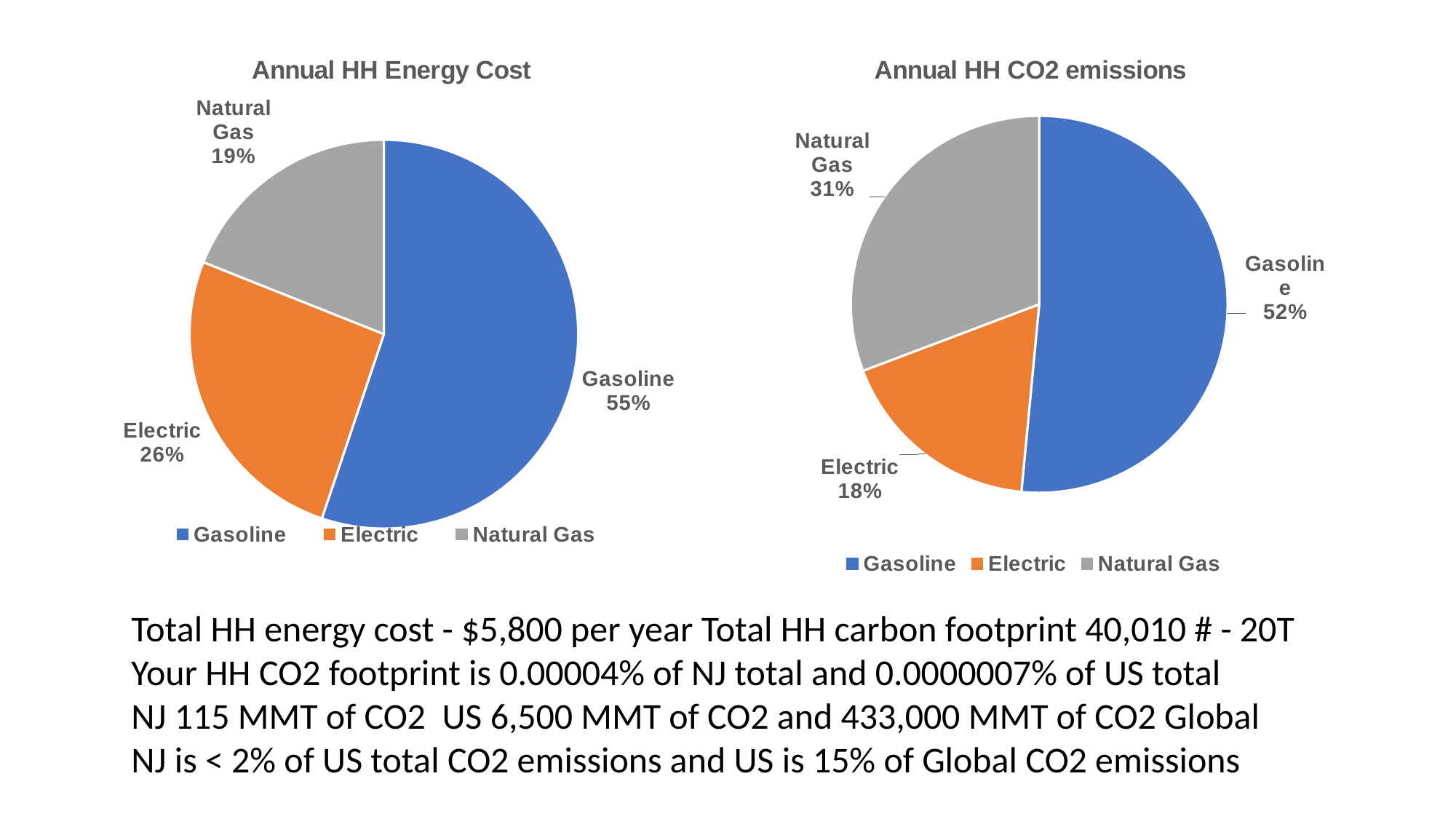
In the 'Annual HH Energy Cost' chart, which category has the smallest slice? Natural Gas In the 'Annual HH CO2 emissions' chart, which is larger, Natural Gas or Electric? Natural Gas How many categories does the 'Annual HH CO2 emissions' chart show? 3 In the 'Annual HH Energy Cost' chart, what share does Gasoline have? 55% In the 'Annual HH CO2 emissions' chart, what share does Natural Gas have? 31% In the 'Annual HH CO2 emissions' chart, which category has the smallest slice? Electric In the 'Annual HH Energy Cost' chart, what share does Electric have? 26% In the 'Annual HH Energy Cost' chart, what is the difference between the Gasoline and Electric shares? 29% What kind of chart is the 'Annual HH Energy Cost' chart? Pie chart In the 'Annual HH CO2 emissions' chart, which category has the largest slice? Gasoline